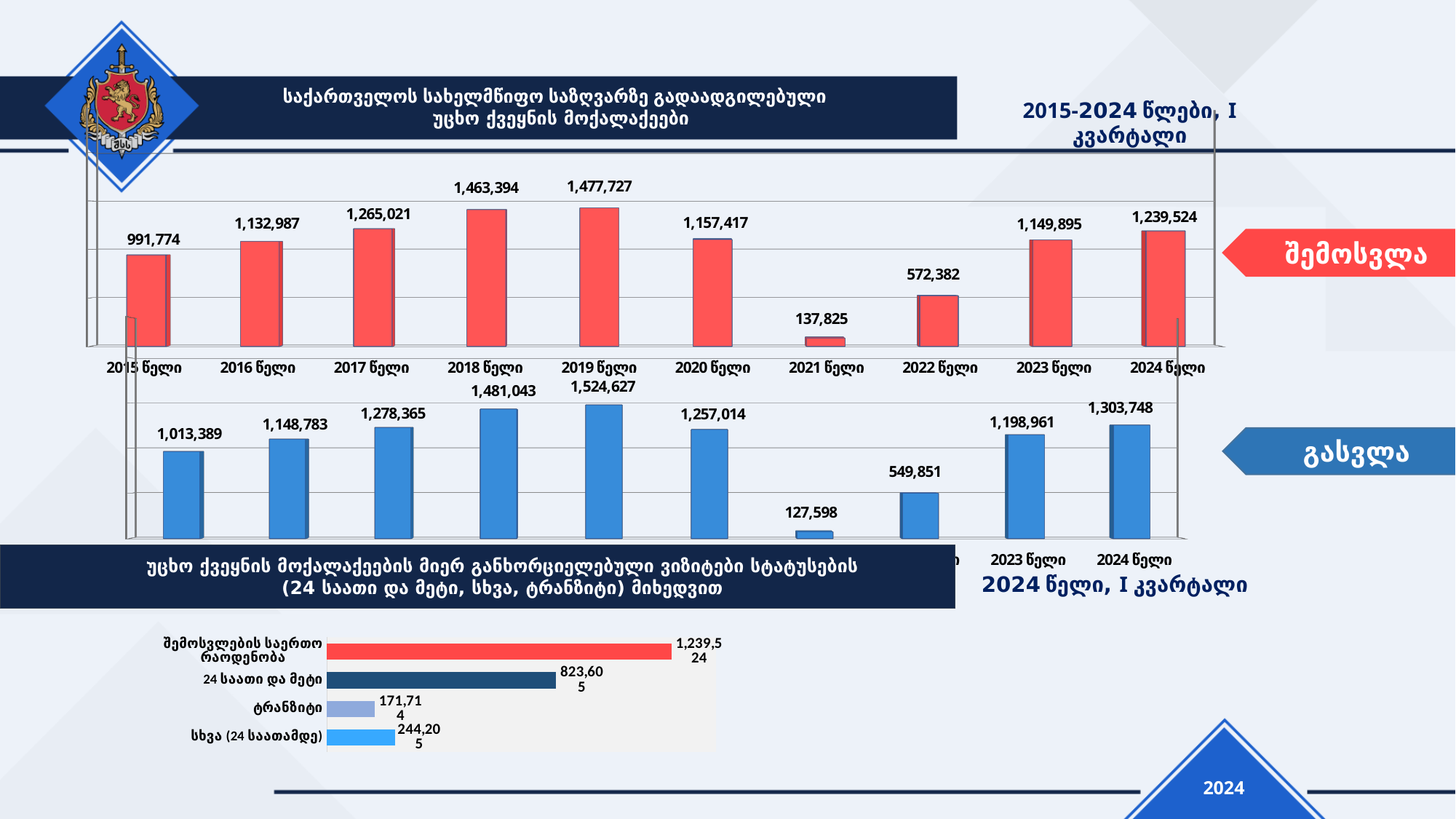
In the top red bar chart (შემოსვლა), what is the value for 2019 წელი? 1,477,727 In the middle blue bar chart (გასვლა), what is the difference between the values for 2019 წელი and 2018 წელი? 43,584 In the middle blue bar chart (გასვლა), is the value for 2021 წელი larger or smaller than the value for 2022 წელი? smaller In the middle blue bar chart (გასვლა), what is the value for 2022 წელი? 549,851 In the bottom horizontal bar chart (2024 წელი, I კვარტალი), what is the value for ტრანზიტი? 171,714 In the bottom horizontal bar chart (2024 წელი, I კვარტალი), which category has the smallest value? ტრანზიტი In the top red bar chart (შემოსვლა), which year has the lowest value? 2021 წელი How many years are shown in the top red bar chart (შემოსვლა)? 10 What type of chart is the bottom chart (2024 წელი, I კვარტალი)? bar chart In the top red bar chart (შემოსვლა), what is the difference between the values for 2024 წელი and 2023 წელი? 89,629 In the top red bar chart (შემოსვლა), which year has the highest value? 2019 წელი In the middle blue bar chart (გასვლა), which year has the highest value? 2019 წელი